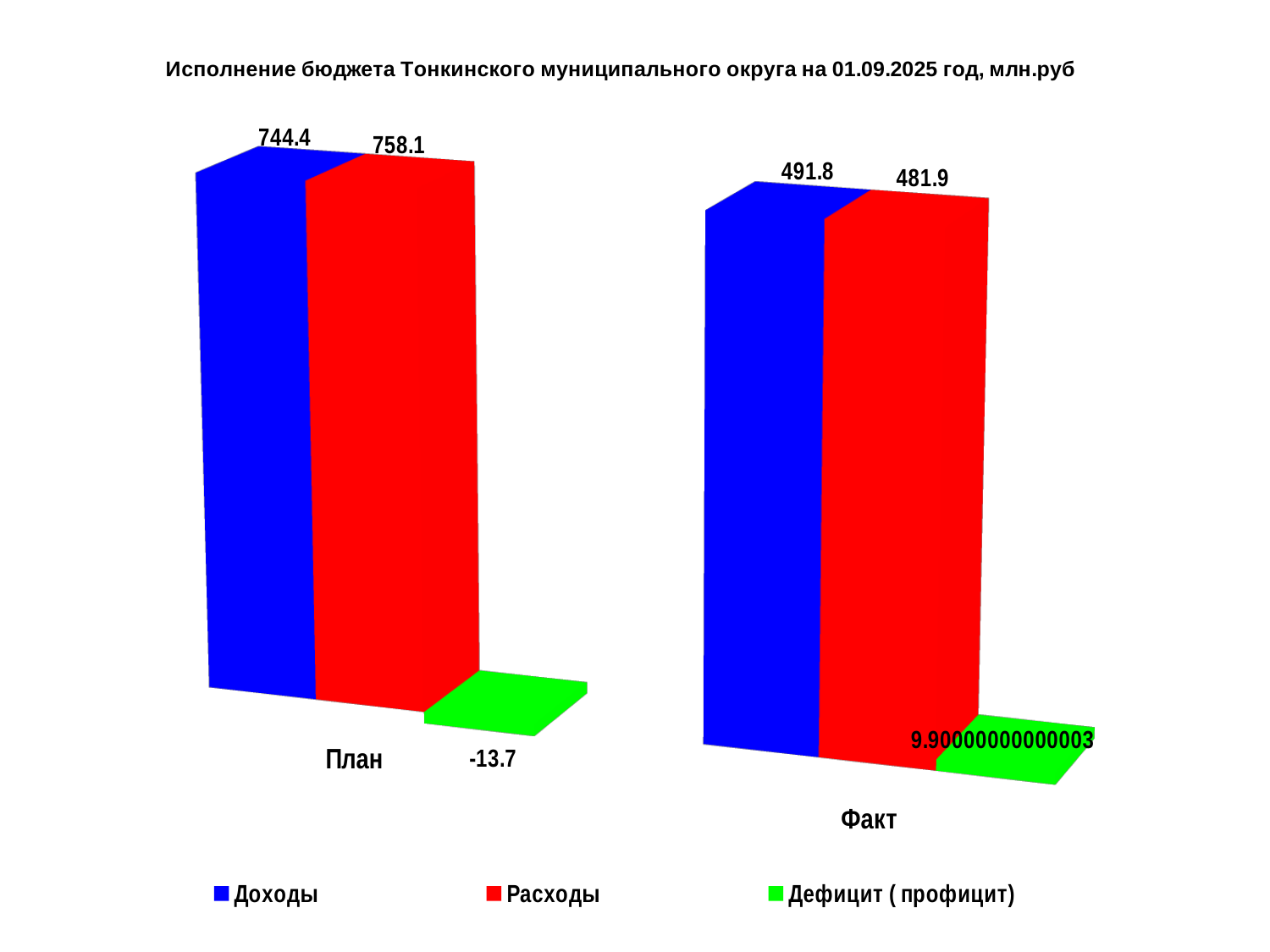
Which is larger for План: Доходы or Расходы? Расходы What is the value of Дефицит (профицит) for План? -13.7 What is the value of Доходы for План? 744.4 How many series does the legend list? 3 What is the value of Расходы for Факт? 481.9 What is the difference between Расходы for План and Расходы for Факт? 276.2 Which is larger for Факт: Доходы or Расходы? Доходы What is the difference between Доходы for План and Доходы for Факт? 252.6 What is the value of Дефицит (профицит) for Факт as printed on the slide? 9.90000000000003 What is the value of Доходы for Факт? 491.8 What is the value of Расходы for План? 758.1 What kind of chart is shown on the slide? Bar chart